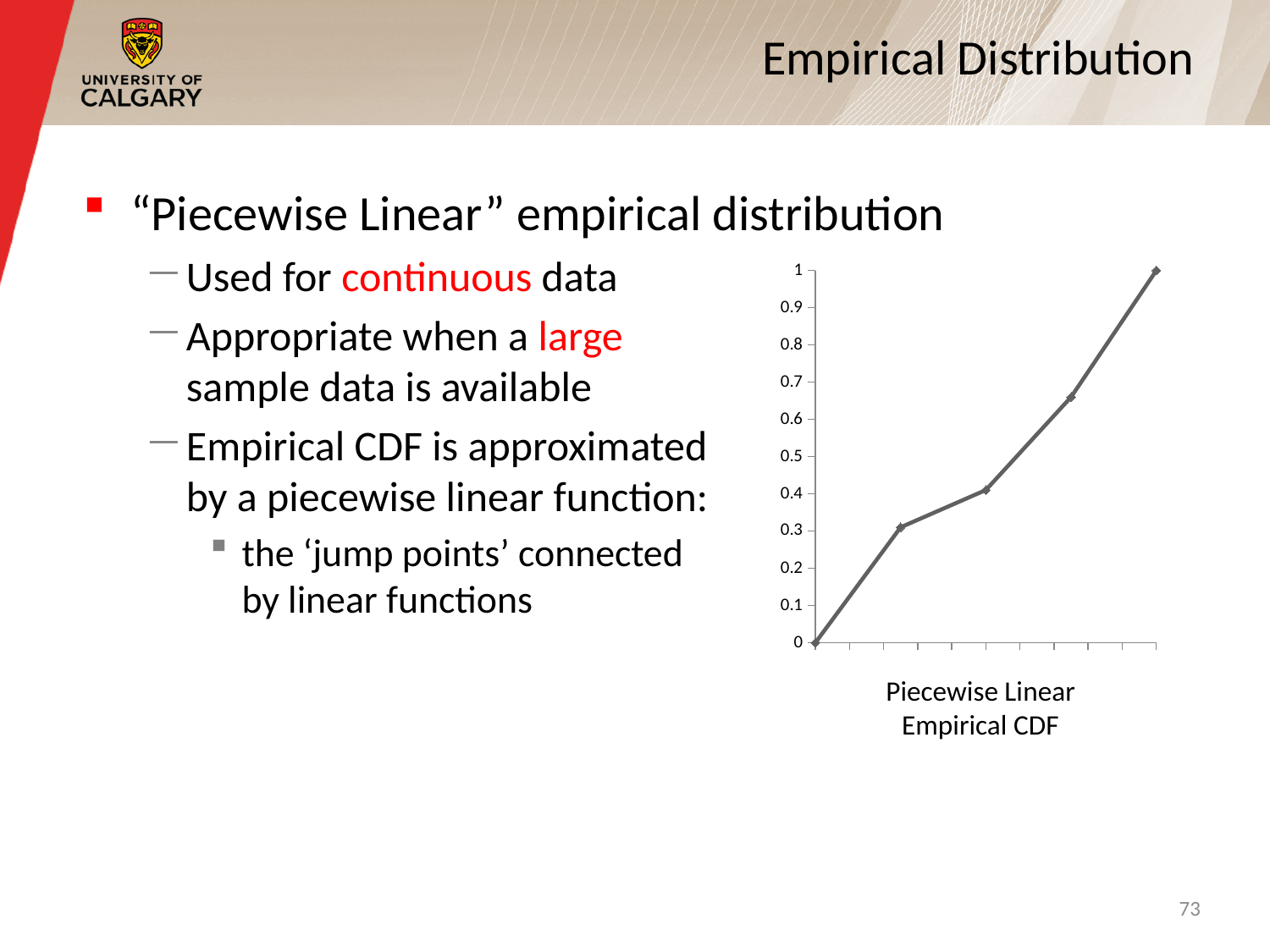
Which is larger on the line chart: the value of the second point from the left or the fourth point from the left? the fourth point from the left Do the values on the line chart rise or fall from left to right? rise How many data points are plotted on the line chart? 5 What caption is shown below the line chart? Piecewise Linear Empirical CDF What is the value of the first (leftmost) point on the line chart? 0 Is the value of the third point from the left on the line chart greater or less than 0.5? less Is the value of the fourth point from the left on the line chart greater or less than 0.6? greater What kind of chart is shown on the slide? line chart Is the value of the second point from the left on the line chart greater or less than 0.4? less What is the value of the last (rightmost) point on the line chart? 1 Which point on the line chart has the lowest value? the leftmost (first) point Which point on the line chart has the highest value? the rightmost (last) point